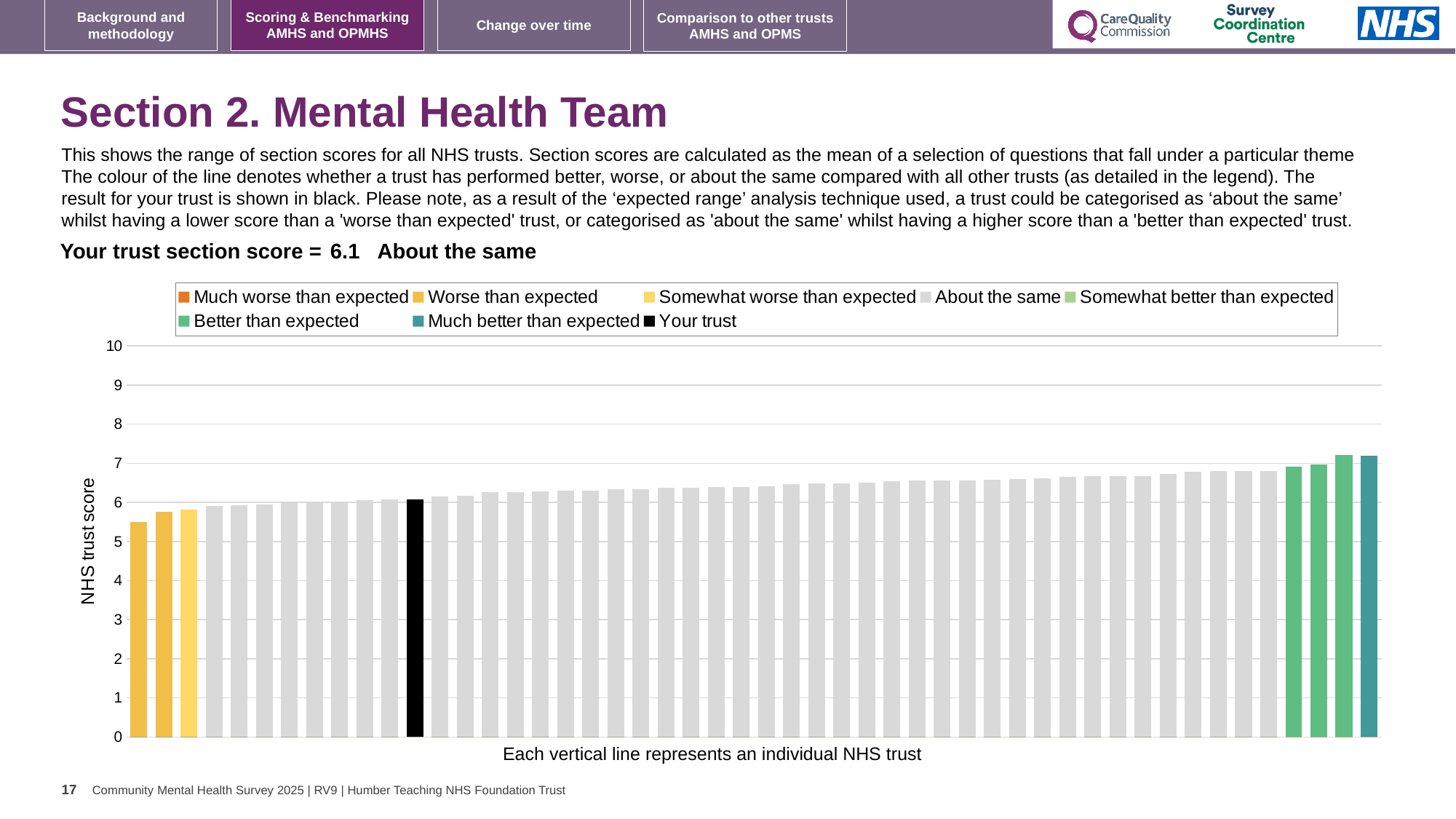
Is the value of the black bar (your trust) greater or less than 5? greater Do the bar values rise or fall from left to right along the x axis? rise What kind of chart is shown on the slide? bar chart What is the section score for your trust shown on the slide? 6.1 What is the label on the y axis of the chart? NHS trust score Is the value of the black bar (your trust) greater or less than 7? less What colour is the bar representing your trust? black How many bars are coloured as 'Worse than expected' (yellow) on the chart? 2 Is the value of the leftmost (lowest) bar greater or less than 5? greater How many entries does the chart legend list? 8 Which category is your trust placed in for this section? About the same